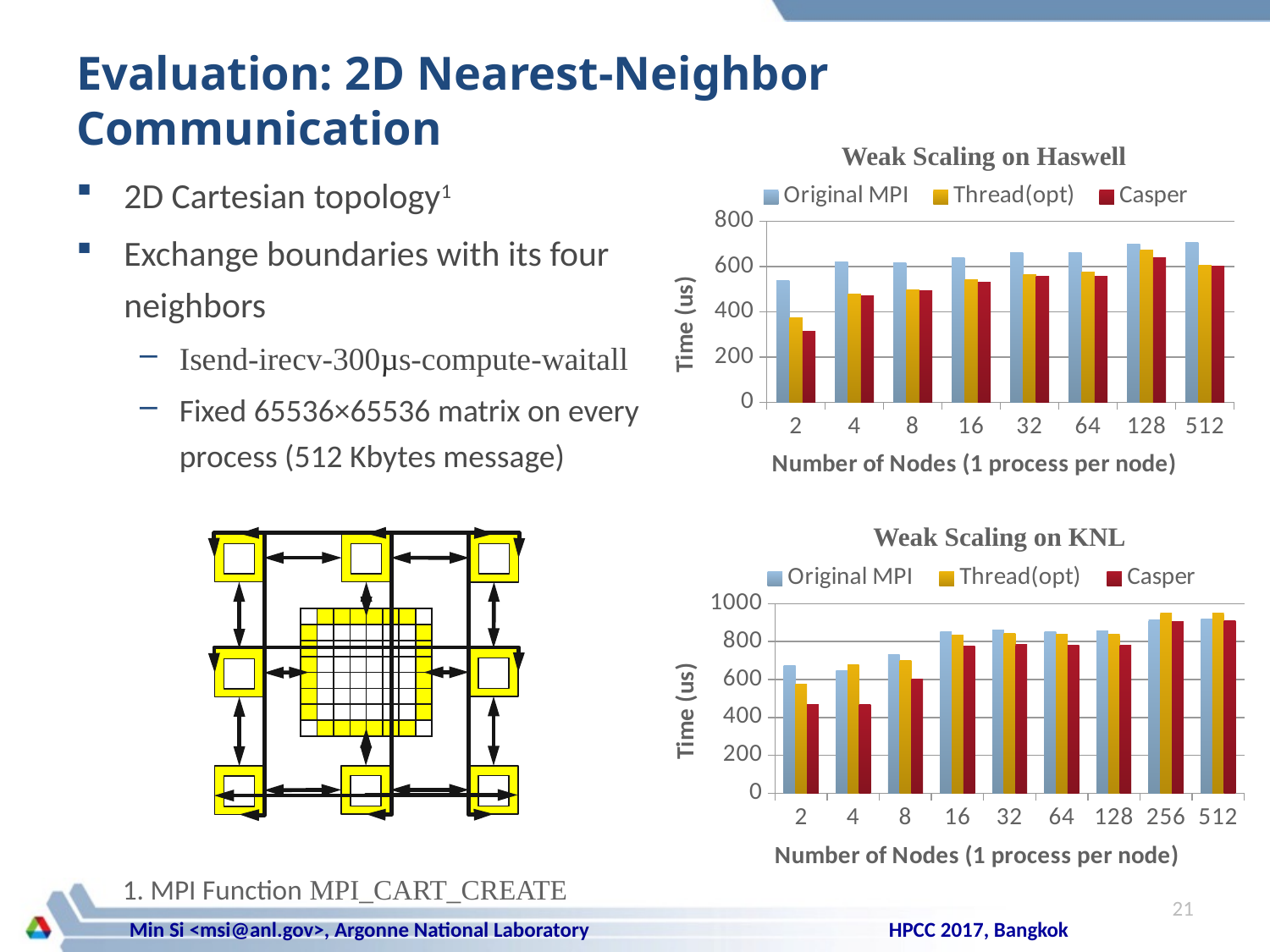
In the 'Weak Scaling on KNL' chart, is the Original MPI value at 16 nodes greater or less than 800? greater What are the three legend entries in the 'Weak Scaling on KNL' chart? Original MPI, Thread(opt), Casper In the 'Weak Scaling on Haswell' chart, at which number of nodes is the Casper value lowest? 2 In the 'Weak Scaling on Haswell' chart, how many node counts are shown on the x axis? 8 In the 'Weak Scaling on KNL' chart, is the Casper value at 2 nodes greater or less than 600? less In the 'Weak Scaling on Haswell' chart, is the Original MPI value at 512 nodes greater or less than 600? greater In the 'Weak Scaling on KNL' chart, how many node counts are shown on the x axis? 9 In the 'Weak Scaling on Haswell' chart, at 2 nodes, which is larger: Original MPI or Casper? Original MPI In the 'Weak Scaling on Haswell' chart, what kind of chart is shown? bar chart In the 'Weak Scaling on KNL' chart, does the Original MPI time generally rise or fall as the number of nodes increases? rise In the 'Weak Scaling on Haswell' chart, how many series does the legend list? 3